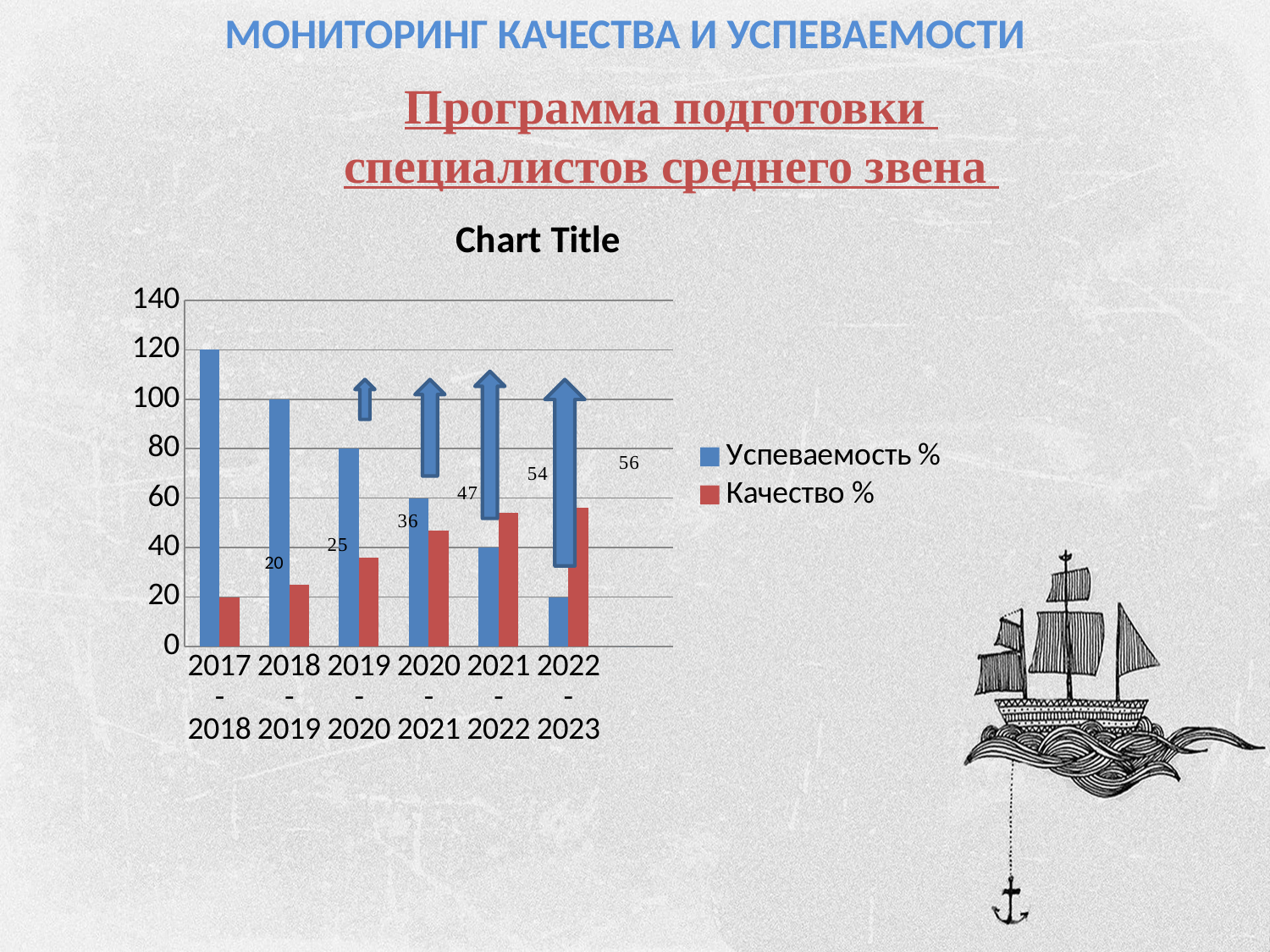
How many series does the chart legend list? 2 What is the Успеваемость % value for 2017-2018? 120 Which academic year has the highest Качество % value? 2022-2023 What is the Качество % value for 2019-2020? 36 How many academic-year categories are shown on the x axis? 6 Which is larger for 2020-2021: Успеваемость % or Качество %? Успеваемость % Which academic year has the lowest Успеваемость % value? 2022-2023 Do the Качество % values rise or fall from 2017-2018 to 2022-2023? rise What colour are the Качество % bars? red What kind of chart is shown on the slide? bar chart What is the difference between the Качество % values for 2021-2022 and 2017-2018? 34 What is the Качество % value for 2022-2023? 56